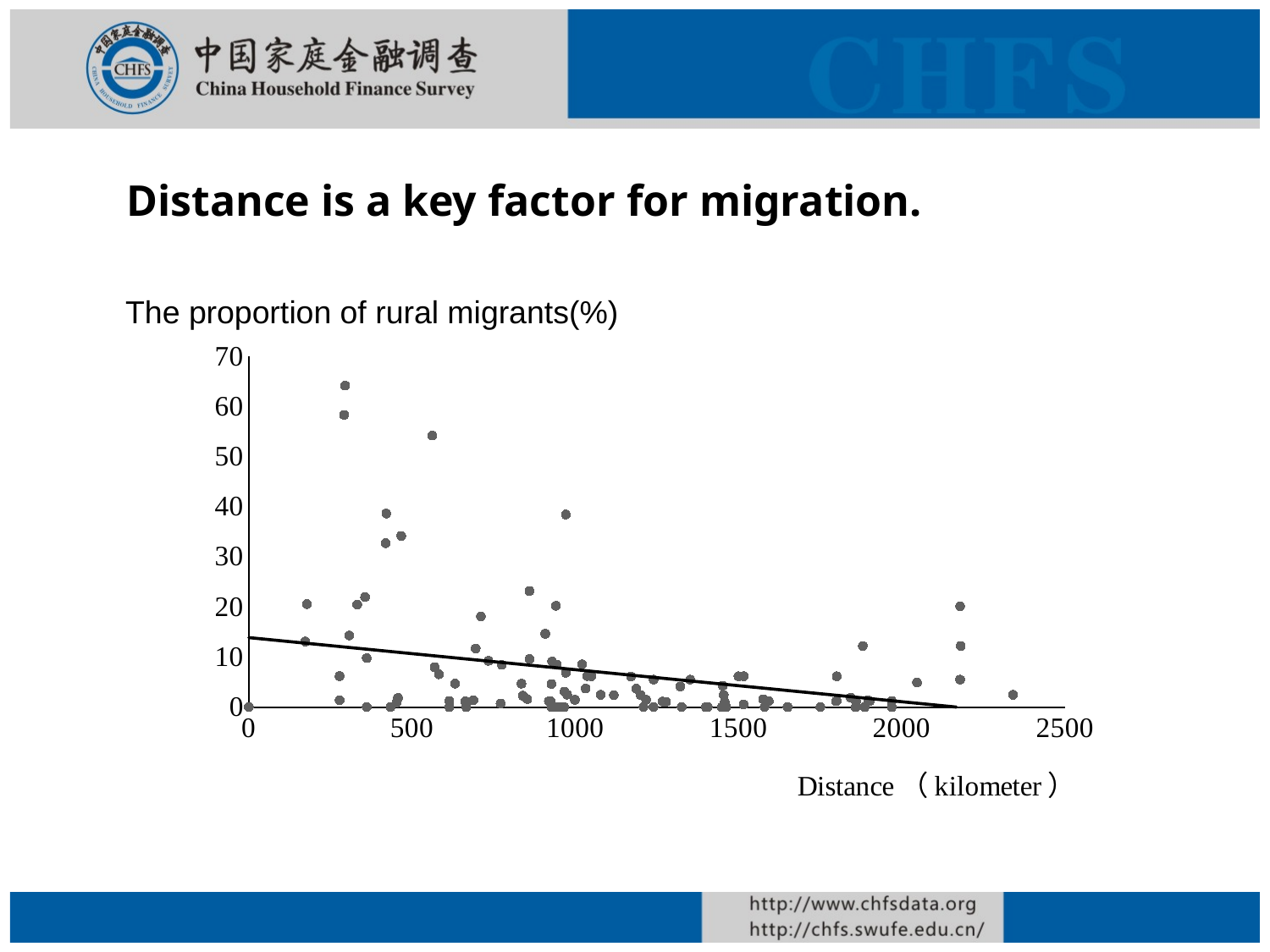
What is the largest tick value shown on the y axis? 70 Is the highest plotted proportion greater or less than 60? greater Does the fitted trend line rise or fall as distance increases? falls What is the label of the x axis? Distance (kilometer) Is the value of the trend line at distance 2000 greater or less than 10? less Between which two x-axis ticks does the trend line reach 0? 2000 and 2500 Is the rightmost plotted point's proportion greater or less than 10? less What kind of chart is shown on the slide? scatter plot